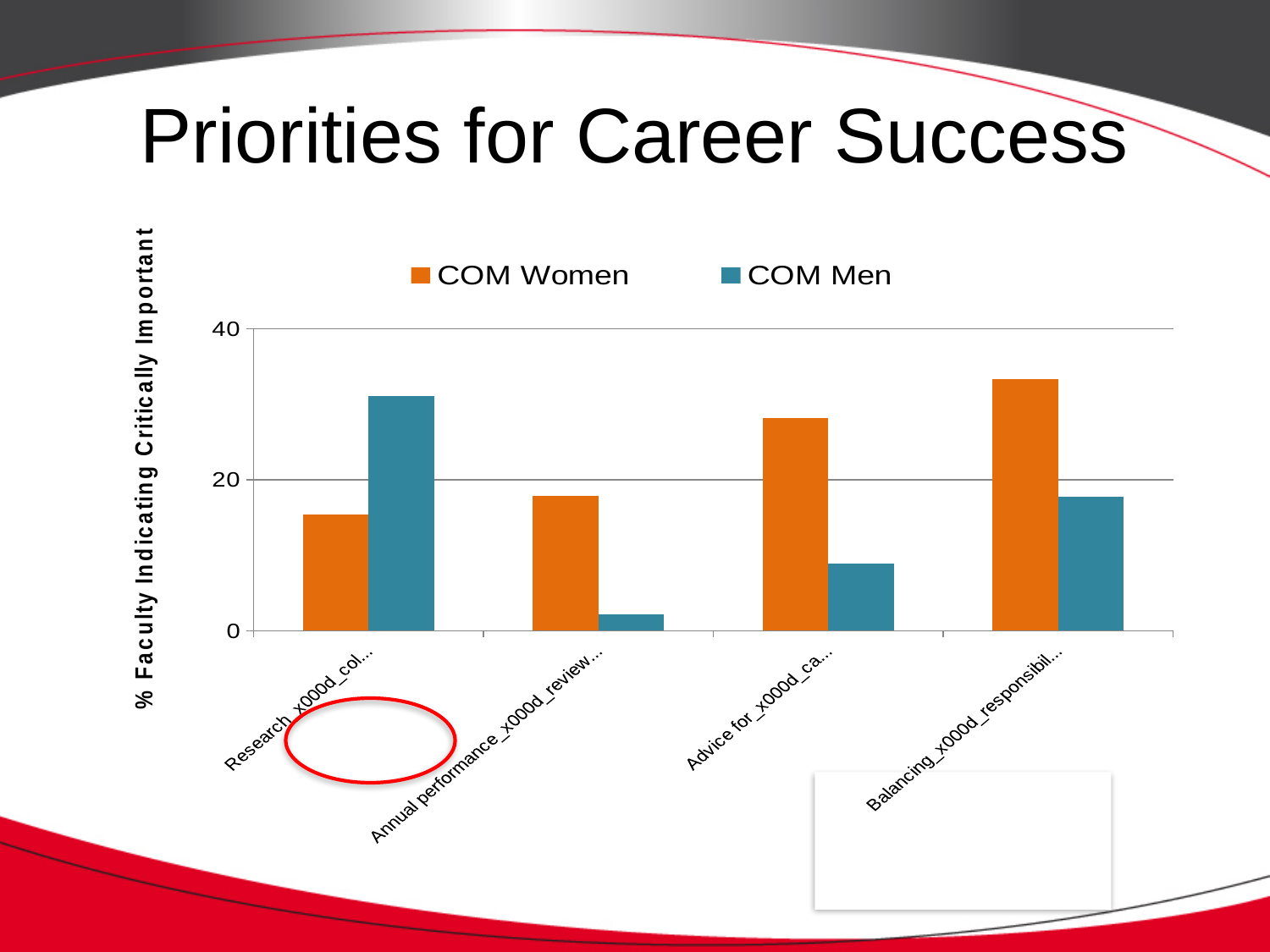
How many categories are shown along the x axis? 4 How many series does the legend list? 2 Is the COM Men value for Research greater or less than 20? greater Is the COM Women value for Balancing responsibilities greater or less than 20? greater What is the title of the y axis? % Faculty Indicating Critically Important For the Research category, which series has the larger value, COM Women or COM Men? COM Men For which category is the COM Men value highest? Research Is the COM Women value for Annual performance review greater or less than 20? less For which category is the COM Women value highest? Balancing responsibilities For which category is the COM Men value lowest? Annual performance review What kind of chart is shown on the slide? bar chart For the Advice for career category, which series has the larger value, COM Women or COM Men? COM Women